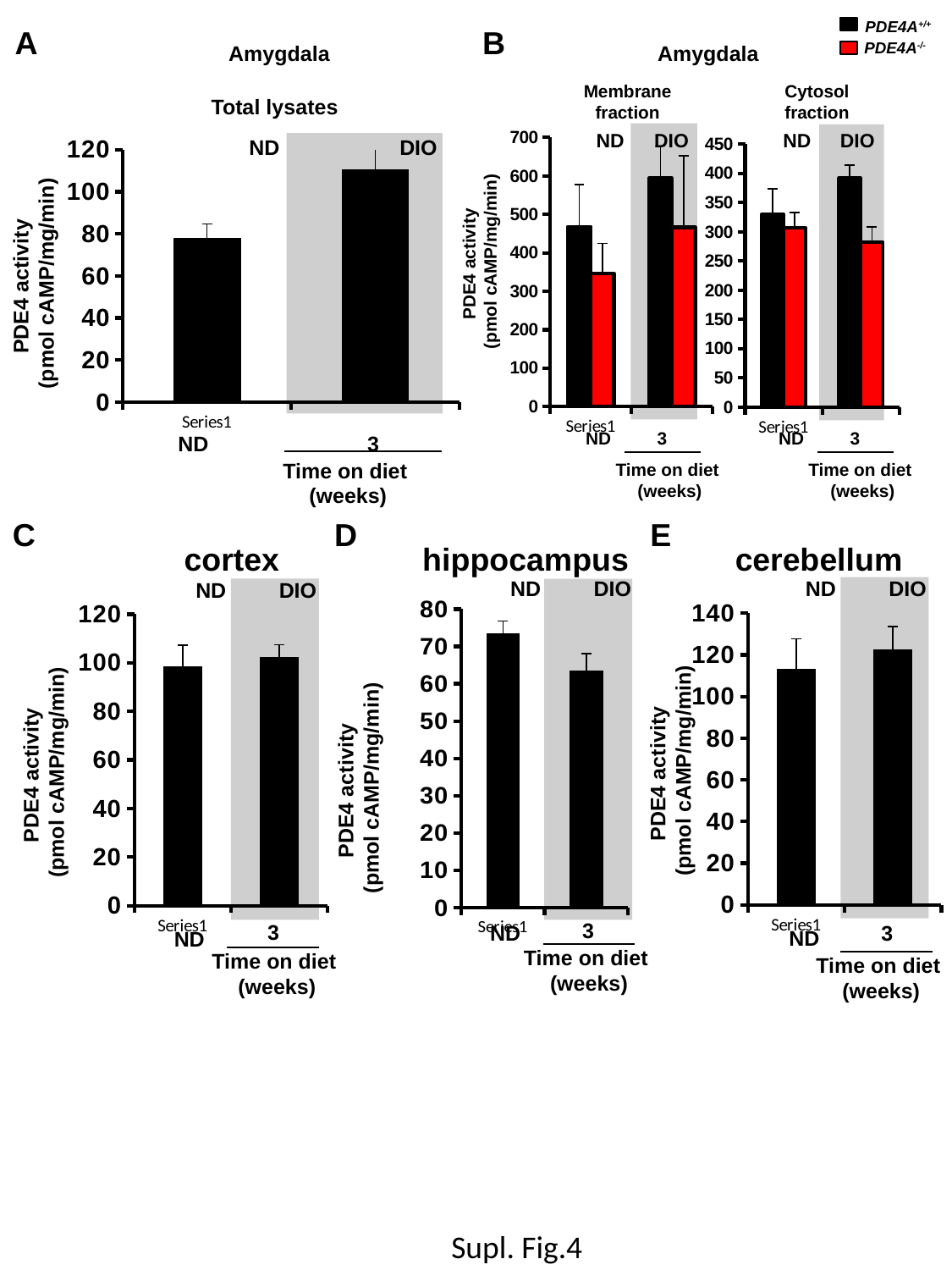
In chart B, Membrane fraction, is the PDE4A-/- value under ND greater or less than 400? less In chart B, Cytosol fraction, under DIO, which series has the larger value, PDE4A+/+ or PDE4A-/-? PDE4A+/+ In chart B, Cytosol fraction, is the PDE4A-/- value under DIO greater or less than 300? less What type of chart is chart A (Amygdala, Total lysates)? bar chart In chart A (Amygdala, Total lysates), which condition has the higher PDE4 activity, ND or DIO? DIO According to the legend, which series is shown in red? PDE4A-/- How many series does the legend at the top right of the slide list? 2 In chart D (hippocampus), which condition has the higher PDE4 activity, ND or DIO? ND In chart A (Amygdala, Total lysates), is the value for DIO greater or less than 100? greater